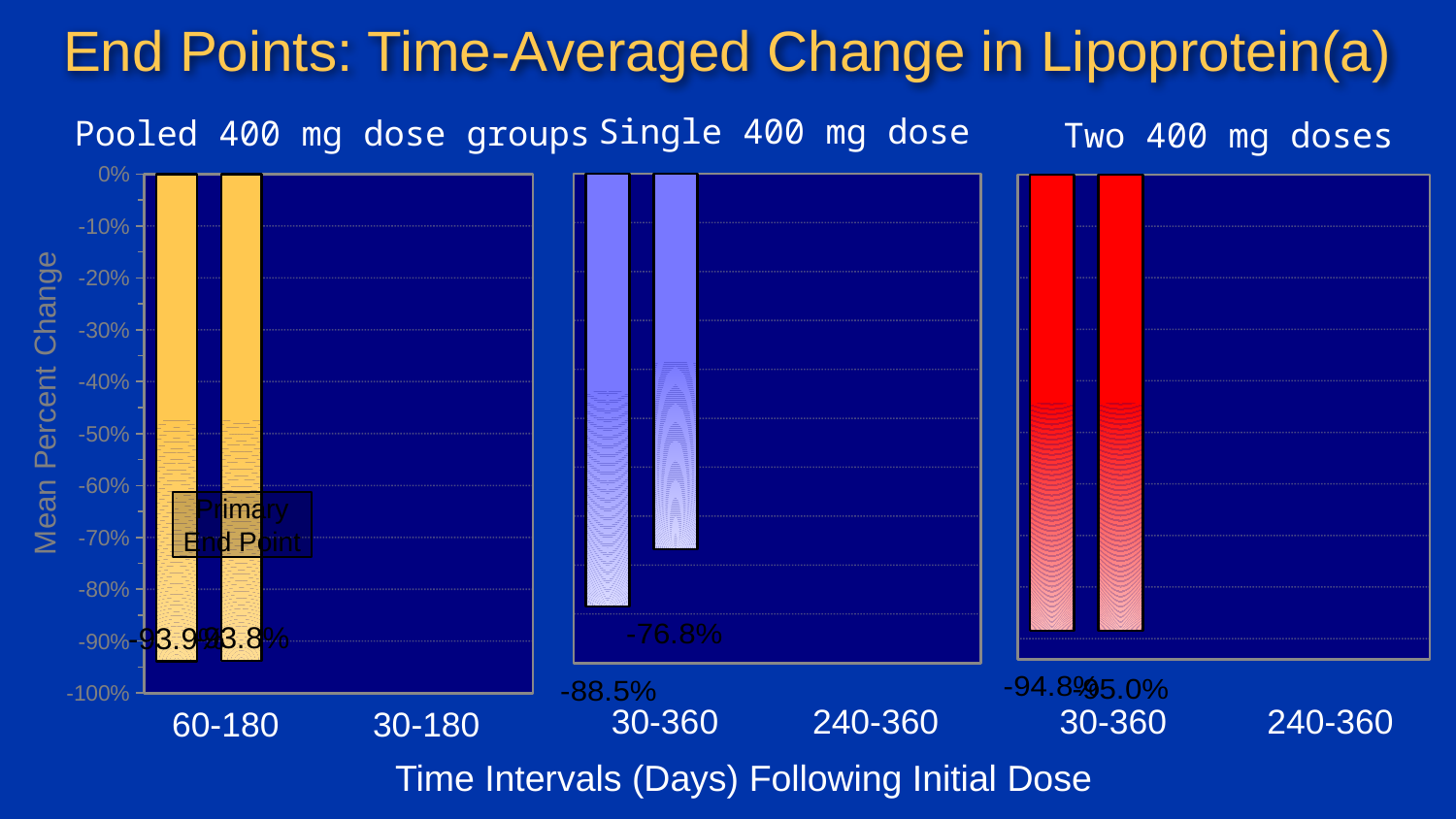
In the Single 400 mg dose chart, which bar shows the larger percent reduction, the left or the right? left What colour are the bars in the Two 400 mg doses chart? red In the Single 400 mg dose chart, what is the difference between the left bar (-88.5%) and the right bar (-76.8%)? 11.7 percentage points In the Single 400 mg dose chart, is the value of the right bar greater or less than -50%? less In the Single 400 mg dose chart, what is the value of the left bar? -88.5% How many charts are shown on the slide? 3 How many bars are plotted in the Two 400 mg doses chart? 2 In the Single 400 mg dose chart, what is the value of the right bar? -76.8% In the Pooled 400 mg dose groups chart, what is the value of the left bar? -93.9% In the Two 400 mg doses chart, what is the value of the left bar? -94.8% What is the y-axis title shared by the charts? Mean Percent Change What kind of chart is used on this slide? bar chart